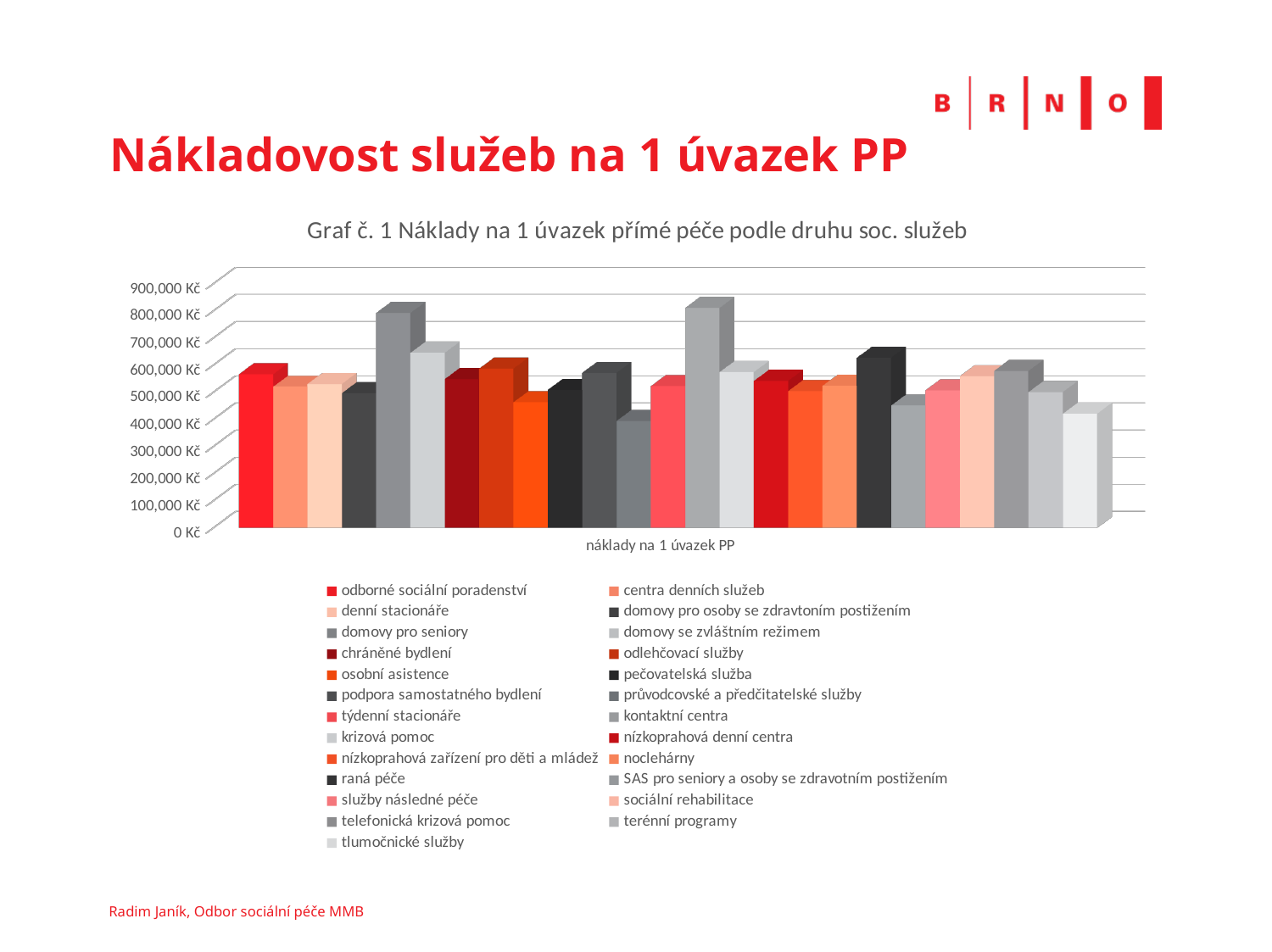
Is the value for průvodcovské a předčitatelské služby greater or less than 500,000 Kč? less Which is larger, the value for domovy pro seniory or the value for průvodcovské a předčitatelské služby? domovy pro seniory How many bars are plotted in the chart? 25 Is the value for tlumočnické služby greater or less than 500,000 Kč? less Is the value for domovy pro seniory greater or less than 700,000 Kč? greater Which is larger, the value for kontaktní centra or the value for krizová pomoc? kontaktní centra What is the title of the chart? Graf č. 1 Náklady na 1 úvazek přímé péče podle druhu soc. služeb What kind of chart is shown on the slide? bar chart What is the label shown on the category axis of the chart? náklady na 1 úvazek PP How many series does the chart legend list? 25